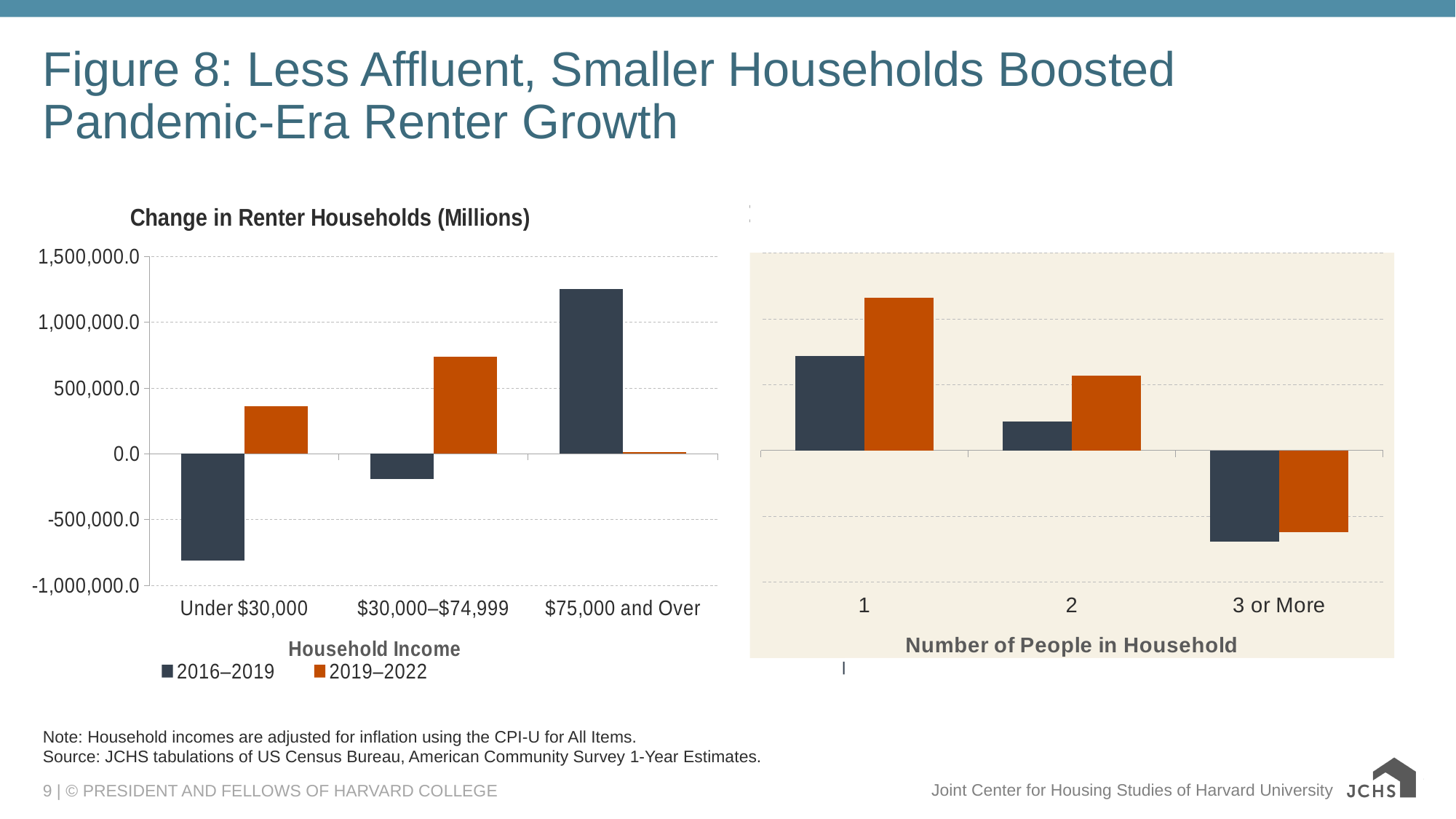
In the left chart (Change in Renter Households), which household income category has the highest value for 2019–2022? $30,000–$74,999 In the left chart (Change in Renter Households), is the 2016–2019 value for Under $30,000 greater or less than -500,000.0? less In the left chart (Change in Renter Households), is the 2016–2019 value for $75,000 and Over greater or less than 1,000,000.0? greater In the right chart (Number of People in Household), which household size has the lowest value for 2016–2019? 3 or More In the left chart (Change in Renter Households), which household income category has the highest value for 2016–2019? $75,000 and Over What kind of chart is the left chart titled 'Change in Renter Households (Millions)'? bar chart In the left chart (Change in Renter Households), how many series does the legend list? 2 In the right chart (Number of People in Household), which household size has the highest value for 2019–2022? 1 In the left chart (Change in Renter Households), which has the larger 2019–2022 value: Under $30,000 or $30,000–$74,999? $30,000–$74,999 In the left chart (Change in Renter Households), which household income category has the lowest value for 2016–2019? Under $30,000 In the left chart (Change in Renter Households), how many household income categories are shown on the x axis? 3 In the right chart (Number of People in Household), how many household size categories are shown on the x axis? 3